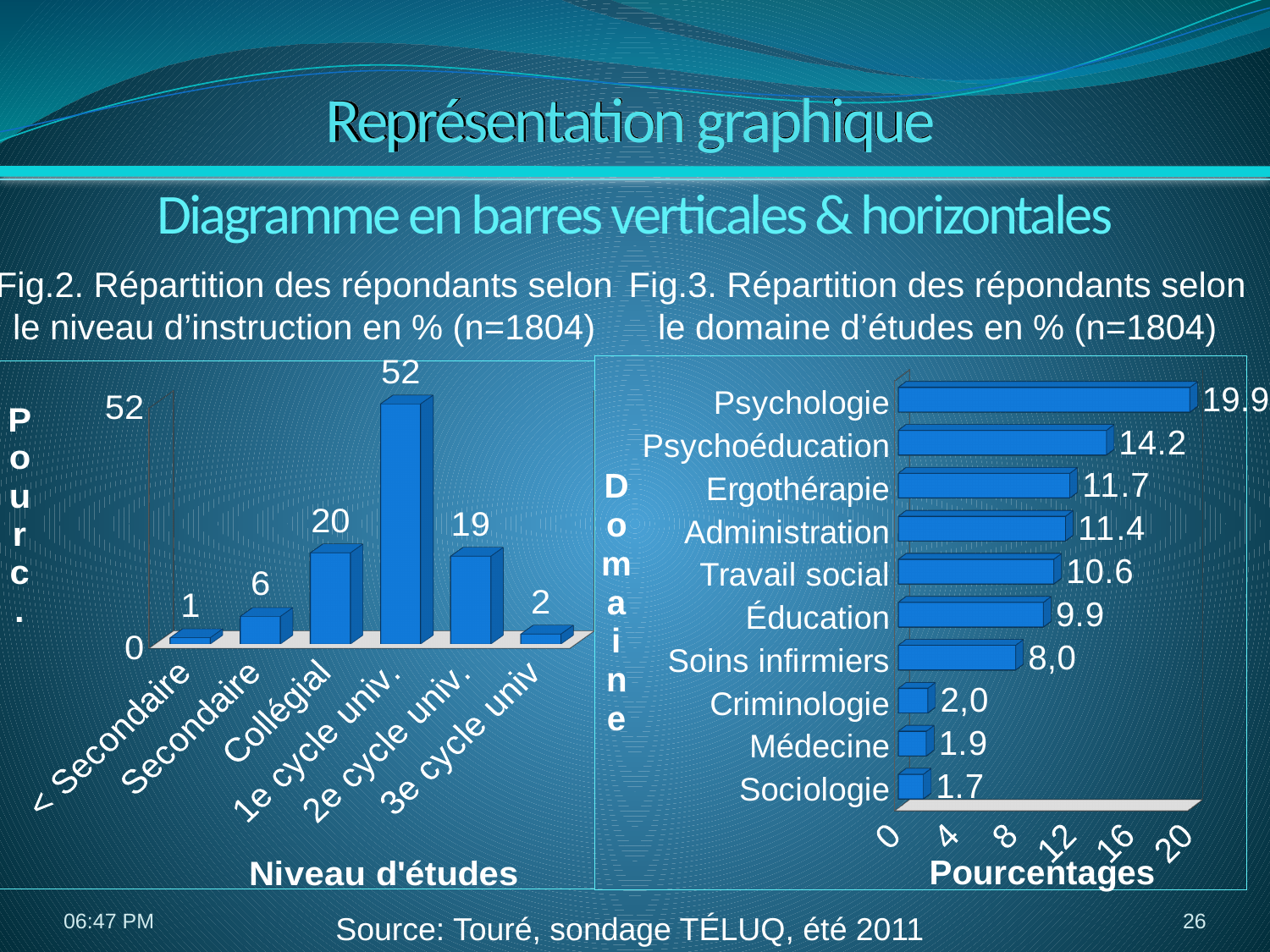
In Fig.2 (left chart), how many levels of education are shown on the x axis? 6 In Fig.3 (right chart), what is the label of the horizontal axis? Pourcentages In Fig.2 (left chart), what is the value for Collégial? 20 In Fig.2 (left chart), which level of education has the highest value? 1e cycle univ. In Fig.3 (right chart), which domain has the lowest percentage? Sociologie In Fig.3 (right chart), which domain has the highest percentage? Psychologie In Fig.3 (right chart), what is the value for Travail social? 10.6 In Fig.3 (right chart), which is larger, the value for Psychoéducation or the value for Ergothérapie? Psychoéducation In Fig.3 (right chart), how many domains are listed? 10 What kind of chart is Fig.2 (left chart)? Bar chart In Fig.2 (left chart), what is the difference between the values for 1e cycle univ. and 2e cycle univ.? 33 In Fig.2 (left chart), which level of education has the lowest value? < Secondaire